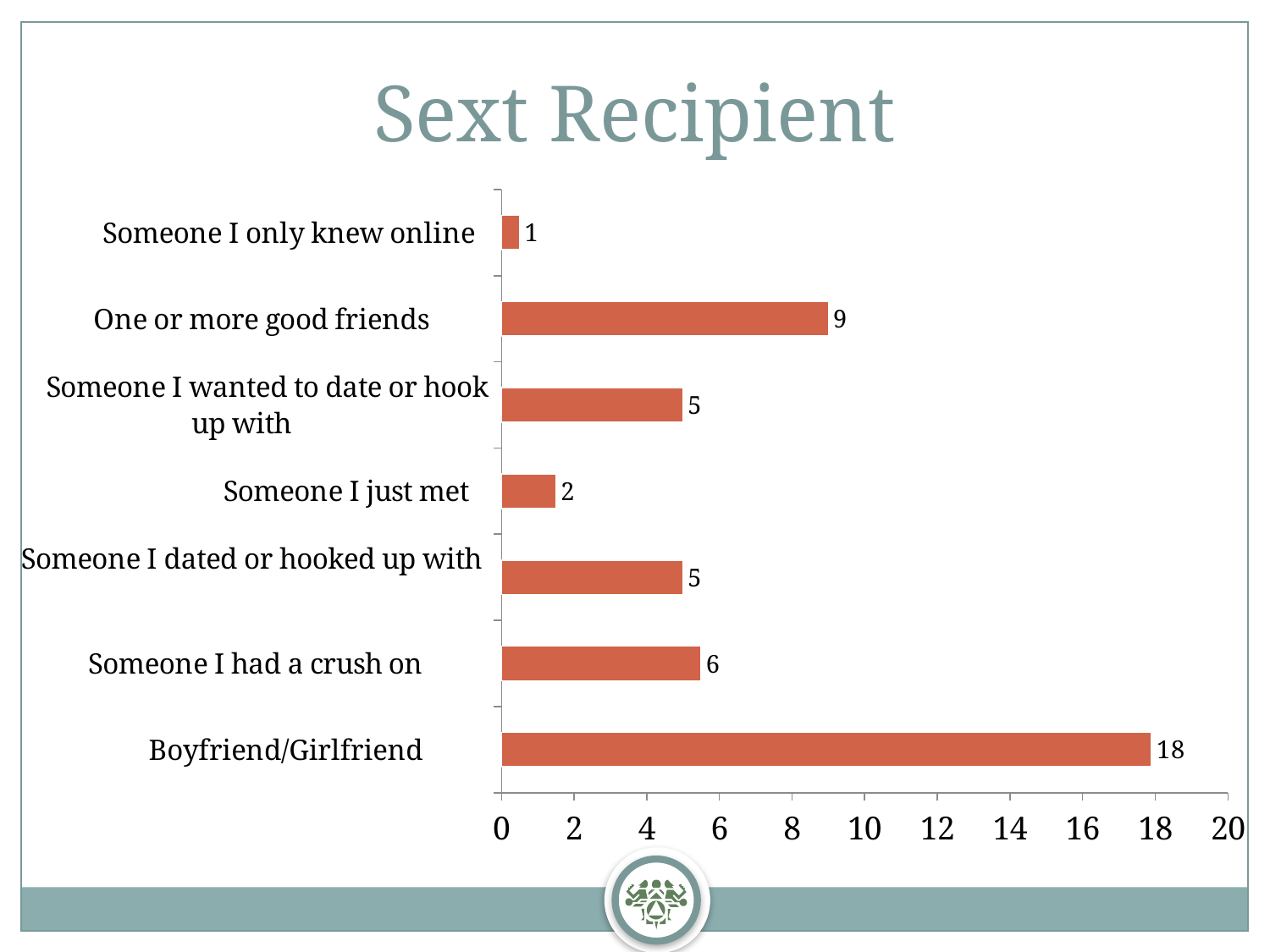
Which category has the highest value? Boyfriend/Girlfriend What is the value for Someone I had a crush on? 6 What is the value for One or more good friends? 9 How many categories are shown in the chart? 7 Which is larger, the value for Someone I had a crush on or the value for Someone I just met? Someone I had a crush on What is the value for Someone I only knew online? 1 What is the title of the chart? Sext Recipient What is the difference between the values for Boyfriend/Girlfriend and One or more good friends? 9 What is the value for Boyfriend/Girlfriend? 18 What kind of chart is shown on the slide? bar chart Is the value for One or more good friends greater or less than 10? less Which category has the lowest value? Someone I only knew online